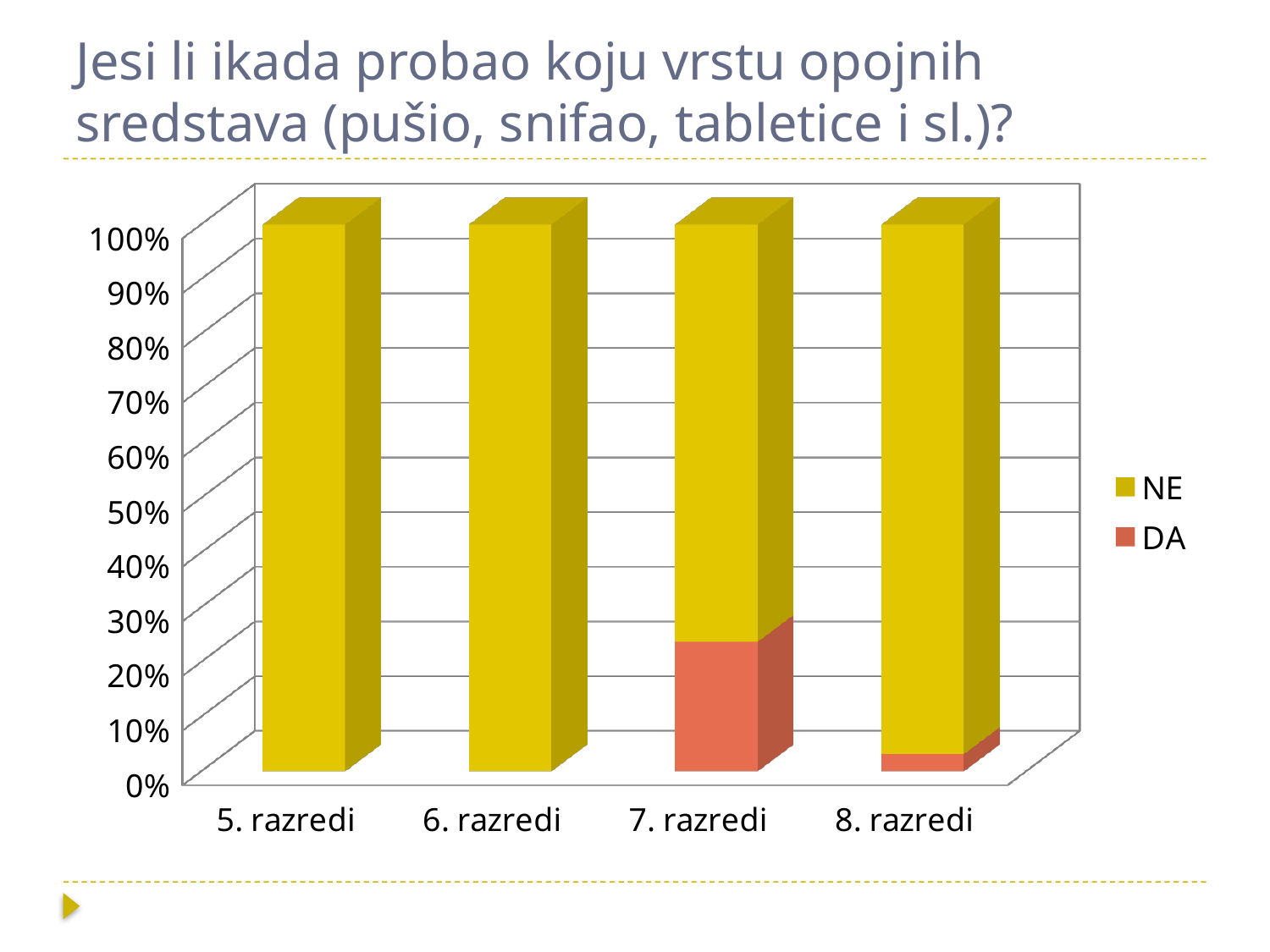
What kind of chart is shown on the slide? bar chart Is the DA share for 8. razredi greater or less than 10%? less Which series are listed in the legend? NE, DA Is the NE share for 7. razredi greater or less than 70%? greater Which class has a larger DA share, 7. razredi or 8. razredi? 7. razredi Is the DA share for 7. razredi greater or less than 30%? less Which class has the largest DA (yes) share? 7. razredi Which classes show no DA (yes) portion at all in their bars? 5. razredi and 6. razredi Which colour represents the NE series? yellow How many categories (classes) are shown on the x axis? 4 How many series does the legend list? 2